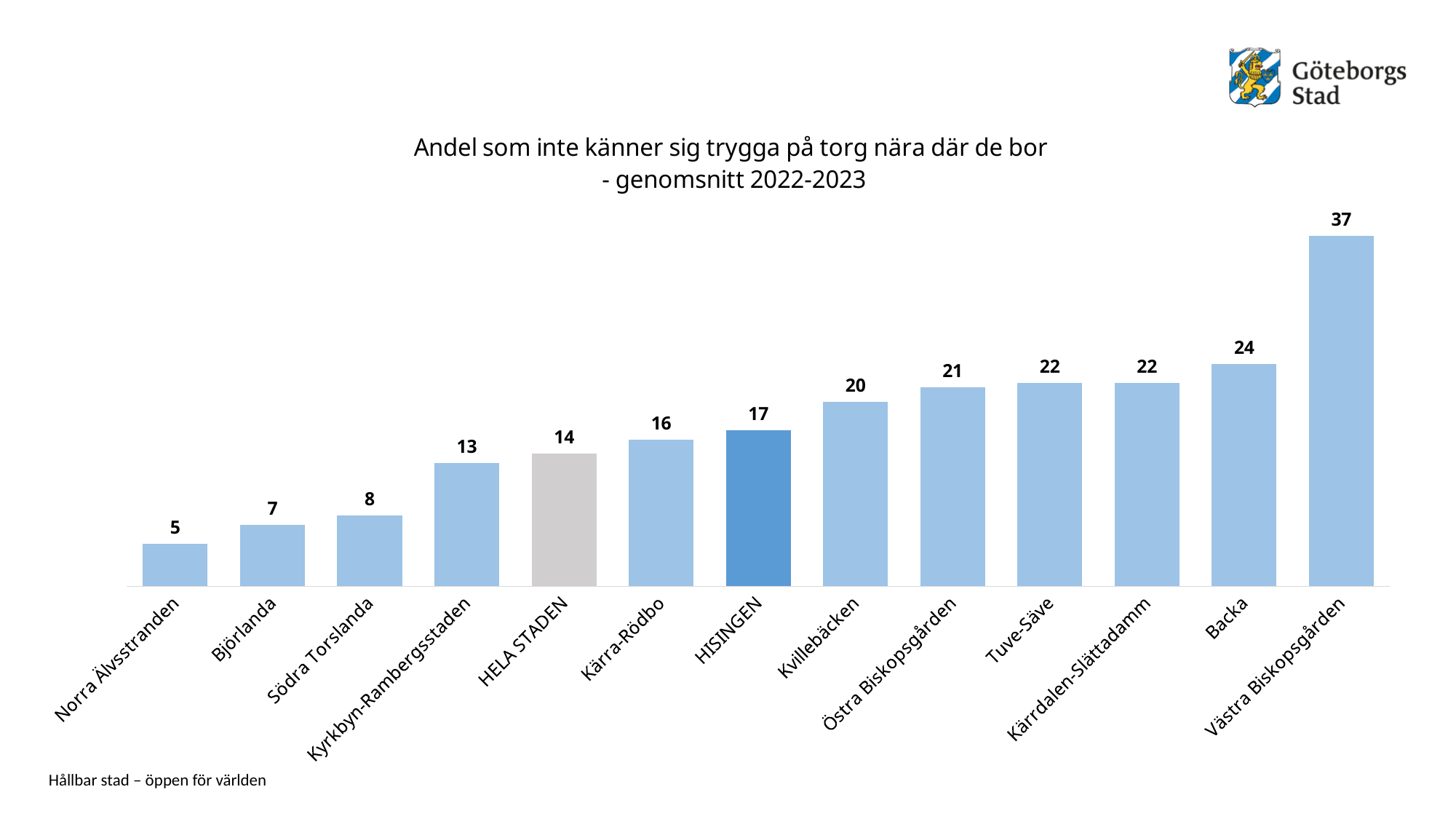
Which has a larger value, Kvillebäcken or Kärra-Rödbo? Kvillebäcken What is the value for Norra Älvsstranden? 5 What kind of chart is this? Bar chart Which category has the highest value? Västra Biskopsgården Do the values rise or fall from left to right along the x axis? Rise What is the difference between the values for HISINGEN and HELA STADEN? 3 Which category has the lowest value? Norra Älvsstranden What is the value for Kärrdalen-Slättadamm? 22 What is the value for HISINGEN? 17 What is the difference between the values for Västra Biskopsgården and Backa? 13 How many categories are shown on the x axis? 13 What is the value for HELA STADEN? 14